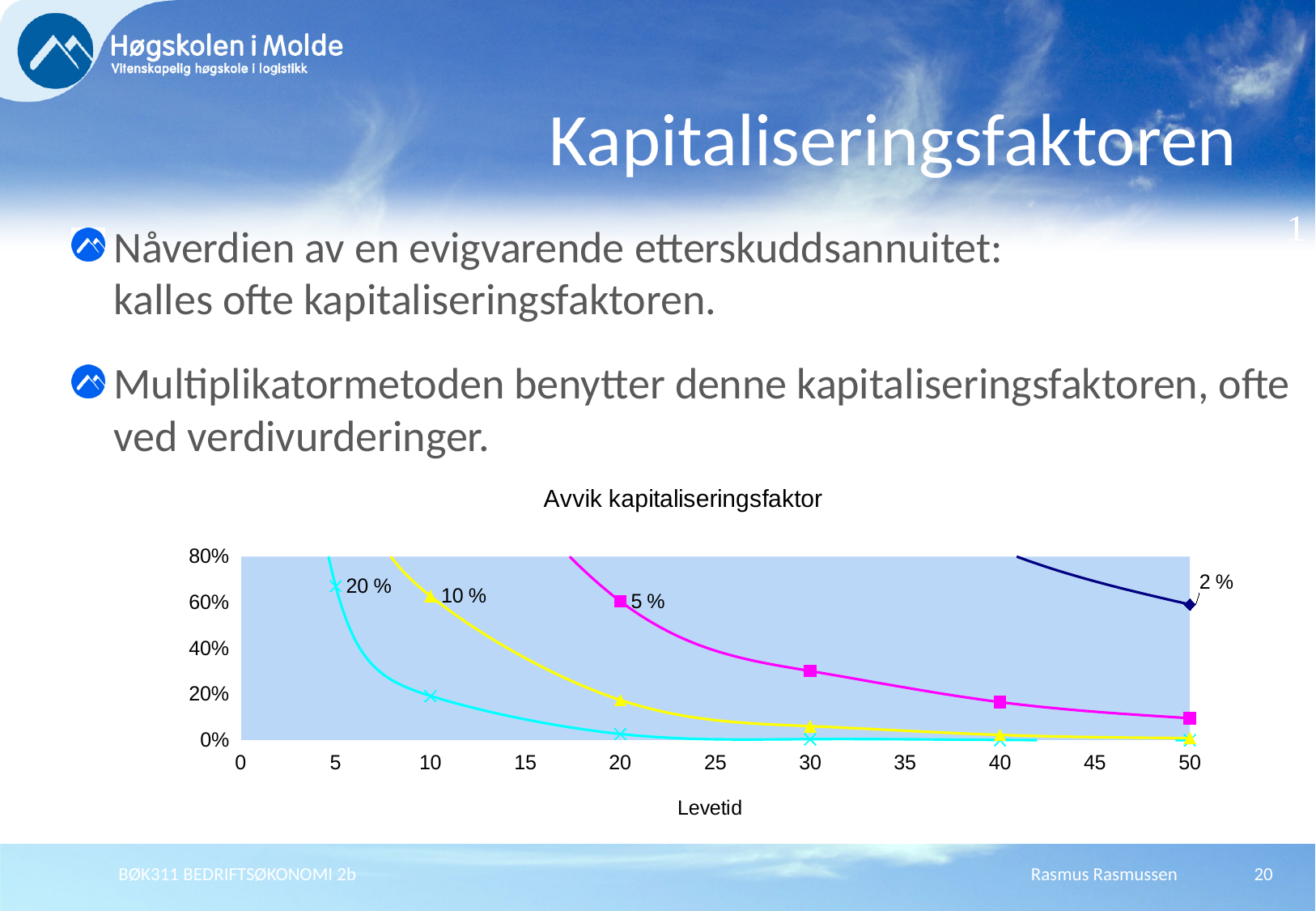
Is the value of the 5 % series at Levetid 30 greater or less than 40%? less What is the label of the x axis of the chart? Levetid Is the value of the 5 % series at Levetid 30 greater or less than 20%? greater What is the title of the chart? Avvik kapitaliseringsfaktor Is the value of the 5 % series at Levetid 50 greater or less than 20%? less What kind of chart is shown on the slide? line chart At Levetid 50, which series has the highest value? 2 % At Levetid 30, which series has the higher value, 5 % or 10 %? 5 % Do the values of the 5 % series rise or fall as Levetid increases? fall How many series are plotted in the chart? 4